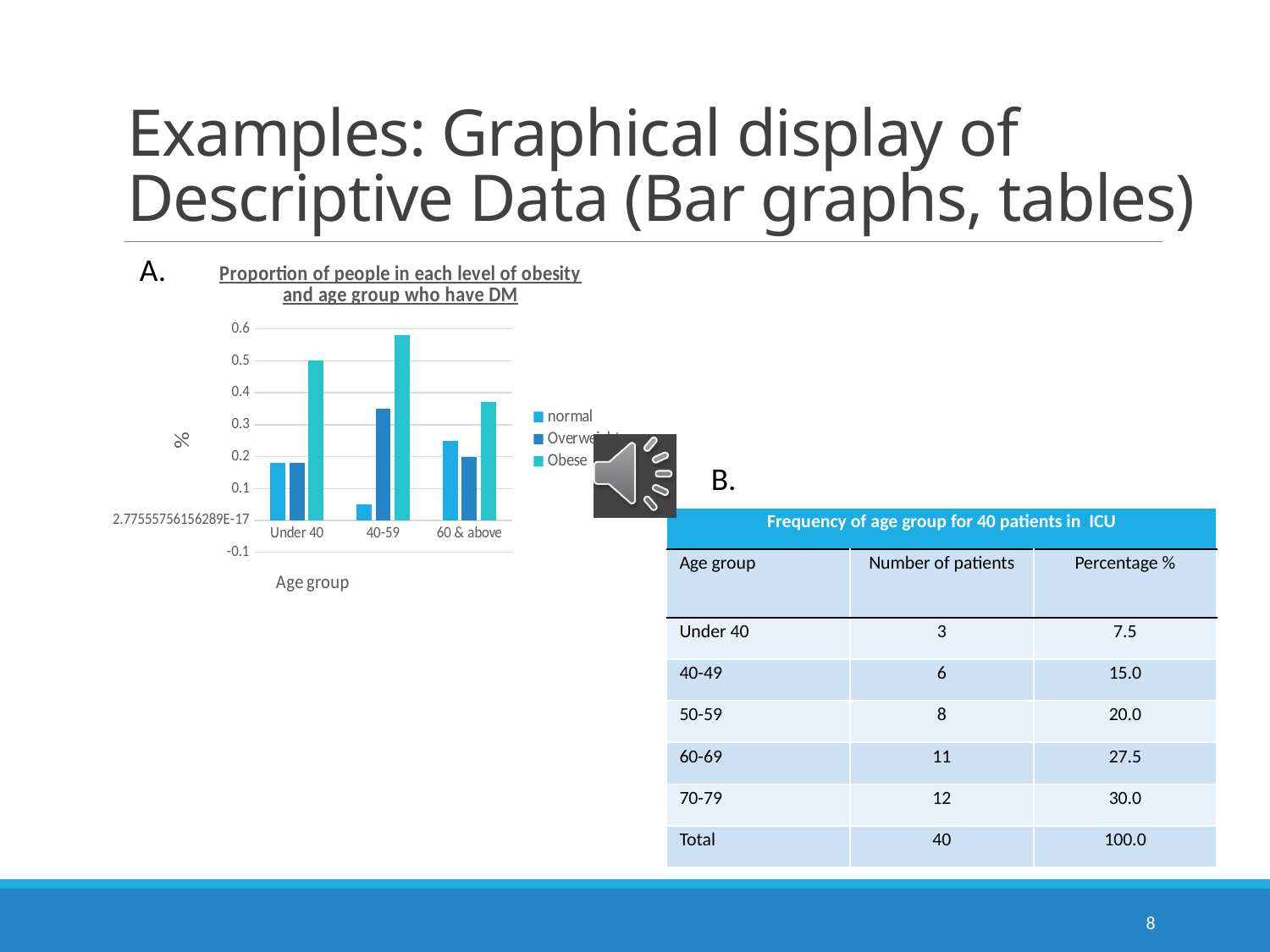
In chart A, is the Obese value for 40-59 greater or less than 0.5? greater How many age groups are shown on the x axis of chart A? 3 What is the title of chart A? Proportion of people in each level of obesity and age group who have DM What is the label on the vertical axis of chart A? % How many series does the legend of chart A list? 3 In chart A, is the Overweight value for 40-59 greater or less than 0.3? greater In chart A, which age group has the lowest normal bar? 40-59 In chart A, is the normal value for 40-59 greater or less than 0.1? less What kind of chart is chart A, 'Proportion of people in each level of obesity and age group who have DM'? bar chart In chart A, for the Under 40 group, which is larger: the Obese bar or the normal bar? Obese In chart A, which age group has the highest Obese bar? 40-59 In chart A, for the 60 & above group, which is larger: the normal bar or the Overweight bar? normal